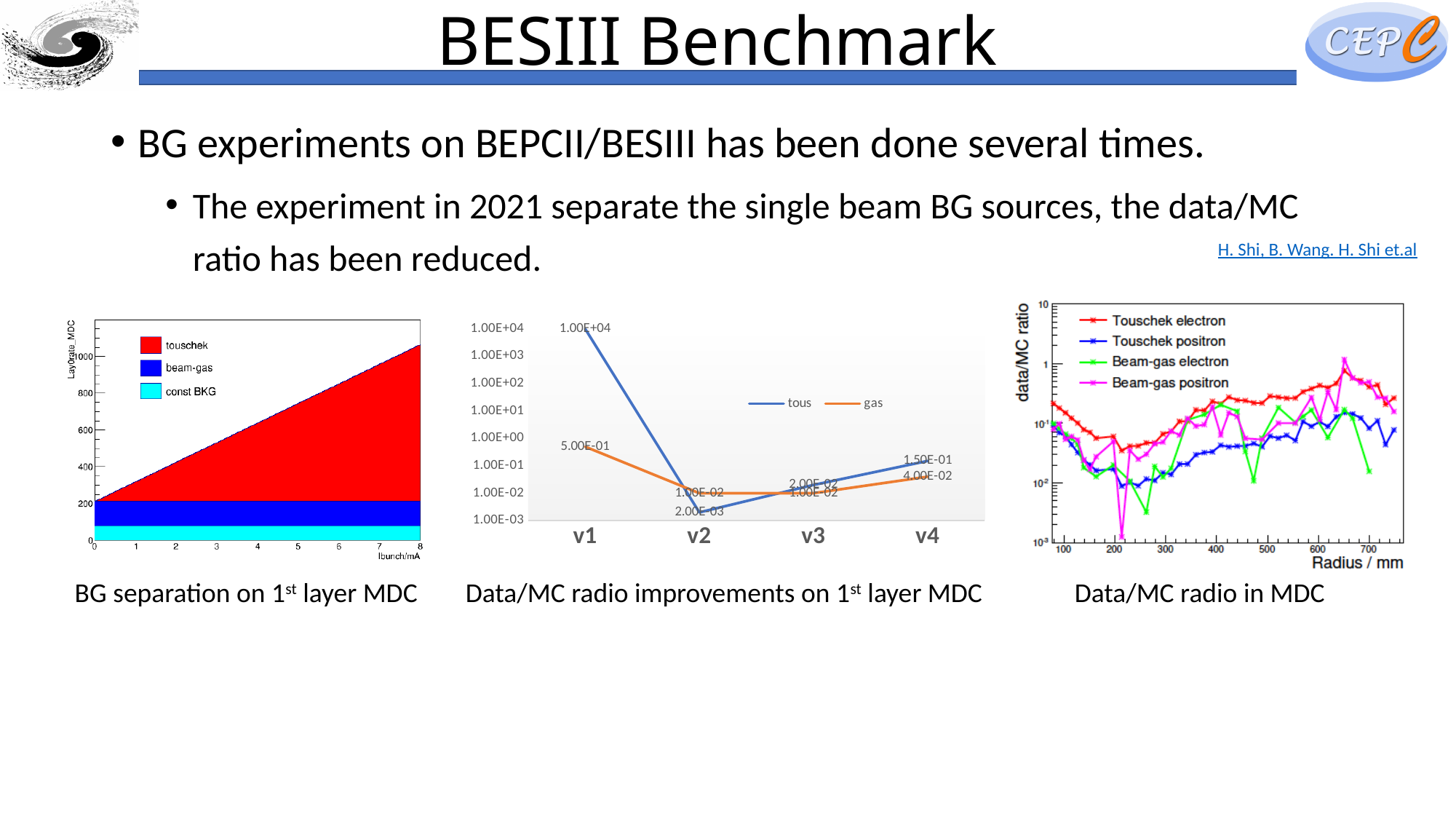
In the middle chart (Data/MC radio improvements on 1st layer MDC), what is the value of the gas series at v1? 5.00E-01 In the middle chart (Data/MC radio improvements on 1st layer MDC), what is the value of the gas series at v4? 4.00E-02 In the middle chart (Data/MC radio improvements on 1st layer MDC), what is the value of the tous series at v1? 1.00E+04 In the middle chart (Data/MC radio improvements on 1st layer MDC), at which category is the tous series lowest? v2 In the middle chart (Data/MC radio improvements on 1st layer MDC), how many series does the legend list? 2 In the middle chart (Data/MC radio improvements on 1st layer MDC), how many categories are shown on the x axis? 4 In the middle chart (Data/MC radio improvements on 1st layer MDC), what is the value of the tous series at v2? 2.00E-03 In the middle chart (Data/MC radio improvements on 1st layer MDC), which series has the larger value at v3, tous or gas? tous In the middle chart (Data/MC radio improvements on 1st layer MDC), what is the value of the tous series at v4? 1.50E-01 What kind of chart is the middle chart (Data/MC radio improvements on 1st layer MDC)? line chart In the middle chart (Data/MC radio improvements on 1st layer MDC), at which category is the tous series highest? v1 In the left chart (BG separation on 1st layer MDC), how many entries does the legend list? 3